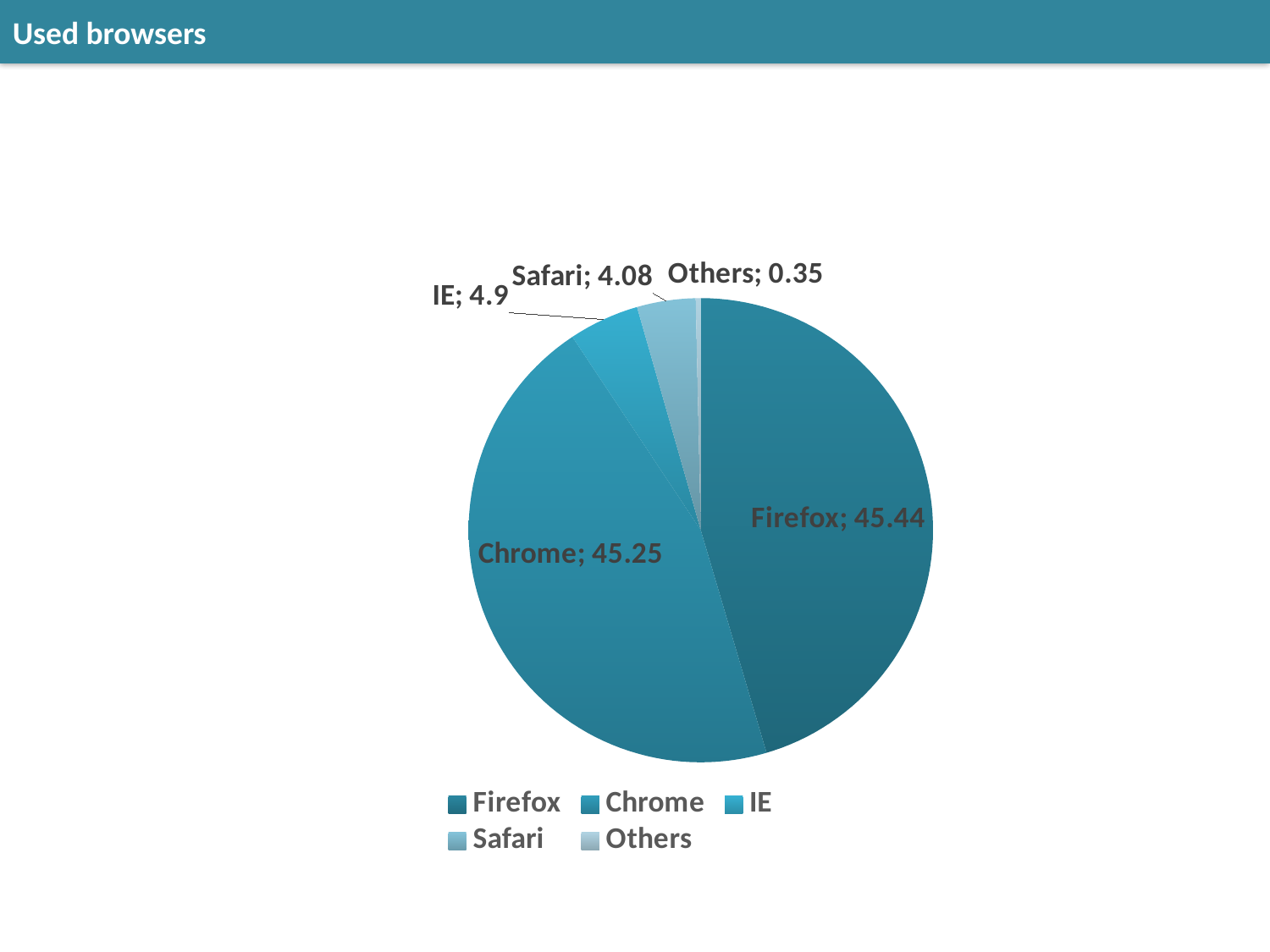
What is the value for Safari? 4.08 Which is larger, the value for IE or the value for Safari? IE What is the value for Firefox? 45.44 What is the difference between the values for Firefox and Chrome? 0.19 Which browser has the largest slice? Firefox What is the value for IE? 4.9 How many browser categories does the legend list? 5 What is the value for Chrome? 45.25 What is the value for Others? 0.35 What kind of chart is shown on the slide? Pie chart What is the difference between the values for IE and Safari? 0.82 Which browser has the smallest slice? Others